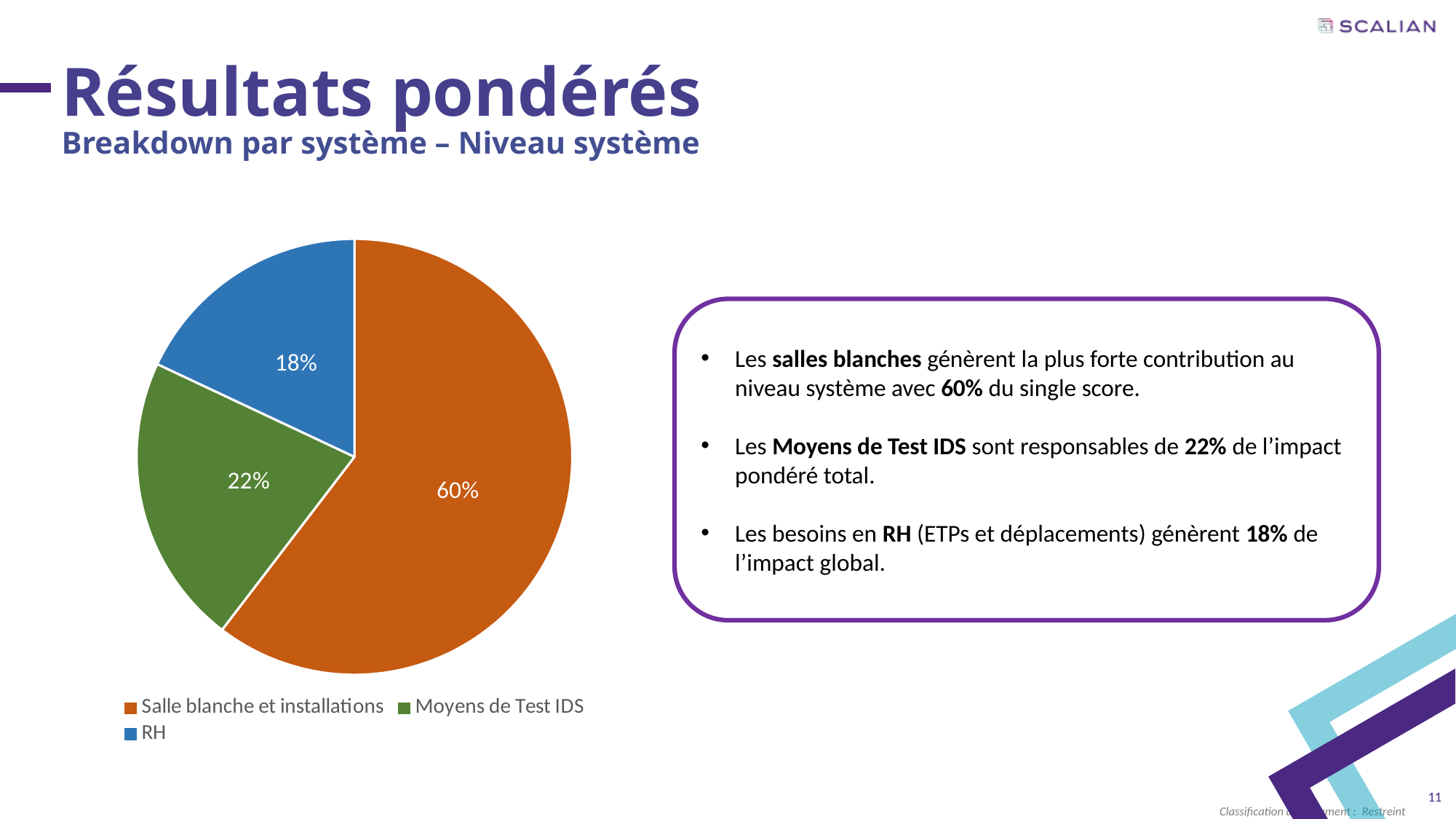
What share of the pie does Moyens de Test IDS represent? 22% Which category has the largest slice of the pie? Salle blanche et installations Which is larger, the share for Moyens de Test IDS or the share for RH? Moyens de Test IDS What share of the pie does Salle blanche et installations represent? 60% What kind of chart is shown on the slide? Pie chart What colour is the slice for RH? Blue What colour is the slice for Moyens de Test IDS? Green What share of the pie does RH represent? 18% Which category has the smallest slice of the pie? RH What is the difference in percentage points between Salle blanche et installations and Moyens de Test IDS? 38 What is the difference in percentage points between Moyens de Test IDS and RH? 4 How many categories are shown in the pie chart? 3